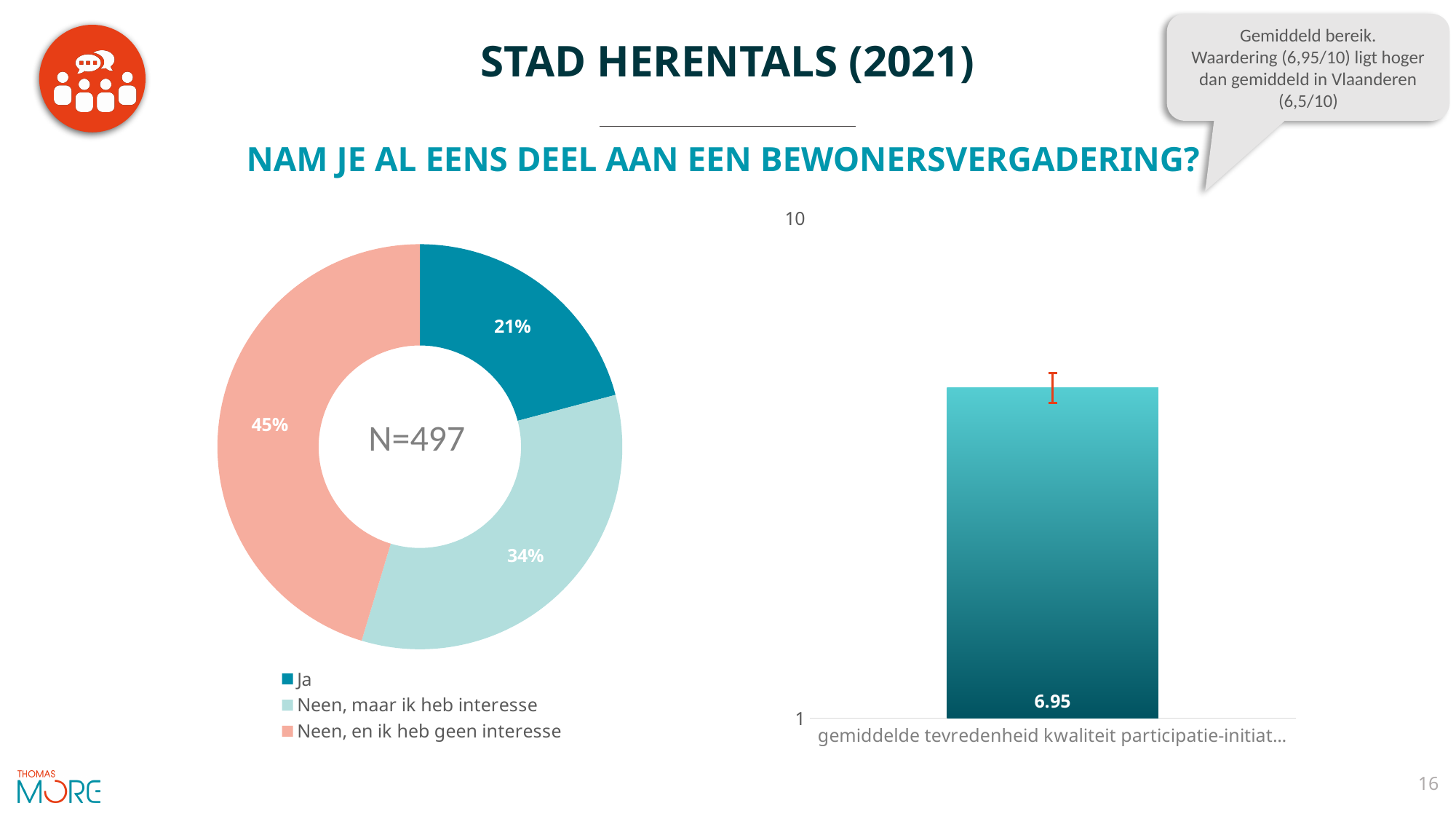
In the doughnut chart on the left, what is the difference in percentage points between 'Neen, en ik heb geen interesse' and 'Ja'? 24 What is the sample size (N) shown in the centre of the doughnut chart on the left? N=497 In the doughnut chart on the left, which answer category has the smallest share? Ja In the bar chart on the right, what is the value of the bar for 'gemiddelde tevredenheid kwaliteit participatie-initiat...'? 6.95 In the doughnut chart on the left, what percentage of respondents answered 'Ja'? 21% In the doughnut chart on the left, what percentage answered 'Neen, en ik heb geen interesse'? 45% In the bar chart on the right, what is the maximum value shown on the vertical axis? 10 What type of chart is shown on the right side of the slide? Bar chart In the doughnut chart on the left, which answer category has the largest share? Neen, en ik heb geen interesse In the doughnut chart on the left, what percentage answered 'Neen, maar ik heb interesse'? 34% How many categories does the legend of the doughnut chart on the left list? 3 In the doughnut chart on the left, which is larger: the share for 'Ja' or the share for 'Neen, maar ik heb interesse'? Neen, maar ik heb interesse